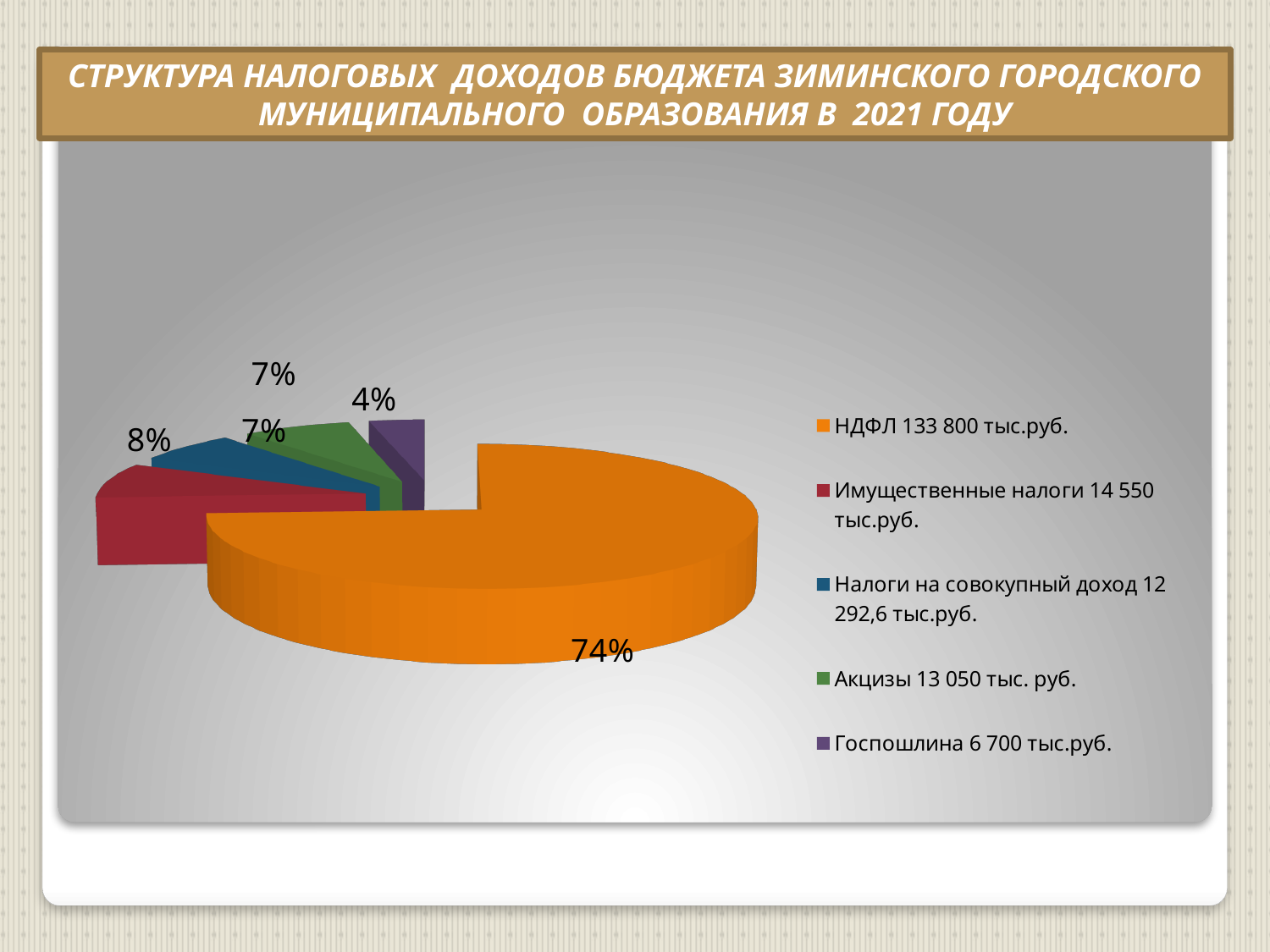
Which category has the largest slice of the pie? НДФЛ What share of the pie does Акцизы account for? 7% How many slices does the pie chart have? 5 What kind of chart is shown on the slide? pie chart What share of the pie does НДФЛ account for? 74% What is the difference in percentage points between the НДФЛ slice and the Имущественные налоги slice? 66 What share of the pie does Госпошлина account for? 4% What colour is the НДФЛ slice in the pie chart? orange According to the legend, what amount in тыс.руб. is given for Акцизы? 13 050 тыс. руб. Which category has the smallest slice of the pie? Госпошлина Which slice is larger, Имущественные налоги or Госпошлина? Имущественные налоги